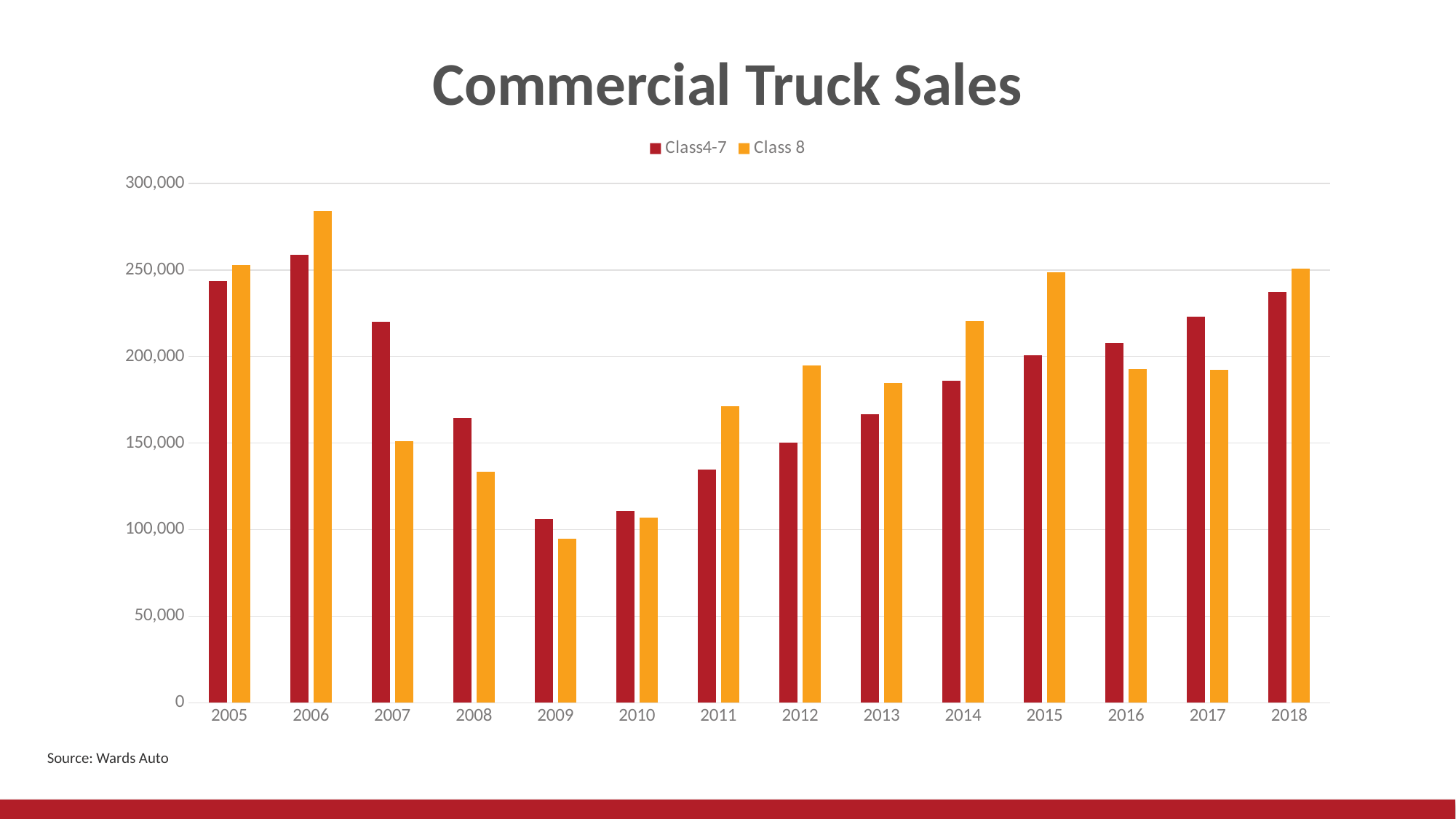
Is the Class 8 value for 2006 greater or less than 250,000? greater In which year is the Class 8 value highest? 2006 Do the Class 8 values rise or fall from 2009 to 2015? rise Is the Class 8 value for 2014 greater or less than 200,000? greater What type of chart is shown on the slide? Bar chart Is the Class4-7 value for 2009 greater or less than 150,000? less How many series does the legend list? 2 In 2007, which series has the larger value, Class4-7 or Class 8? Class4-7 How many years are shown on the x axis? 14 In which year is the Class4-7 value lowest? 2009 In which year is the Class4-7 value highest? 2006 In which year is the Class 8 value lowest? 2009